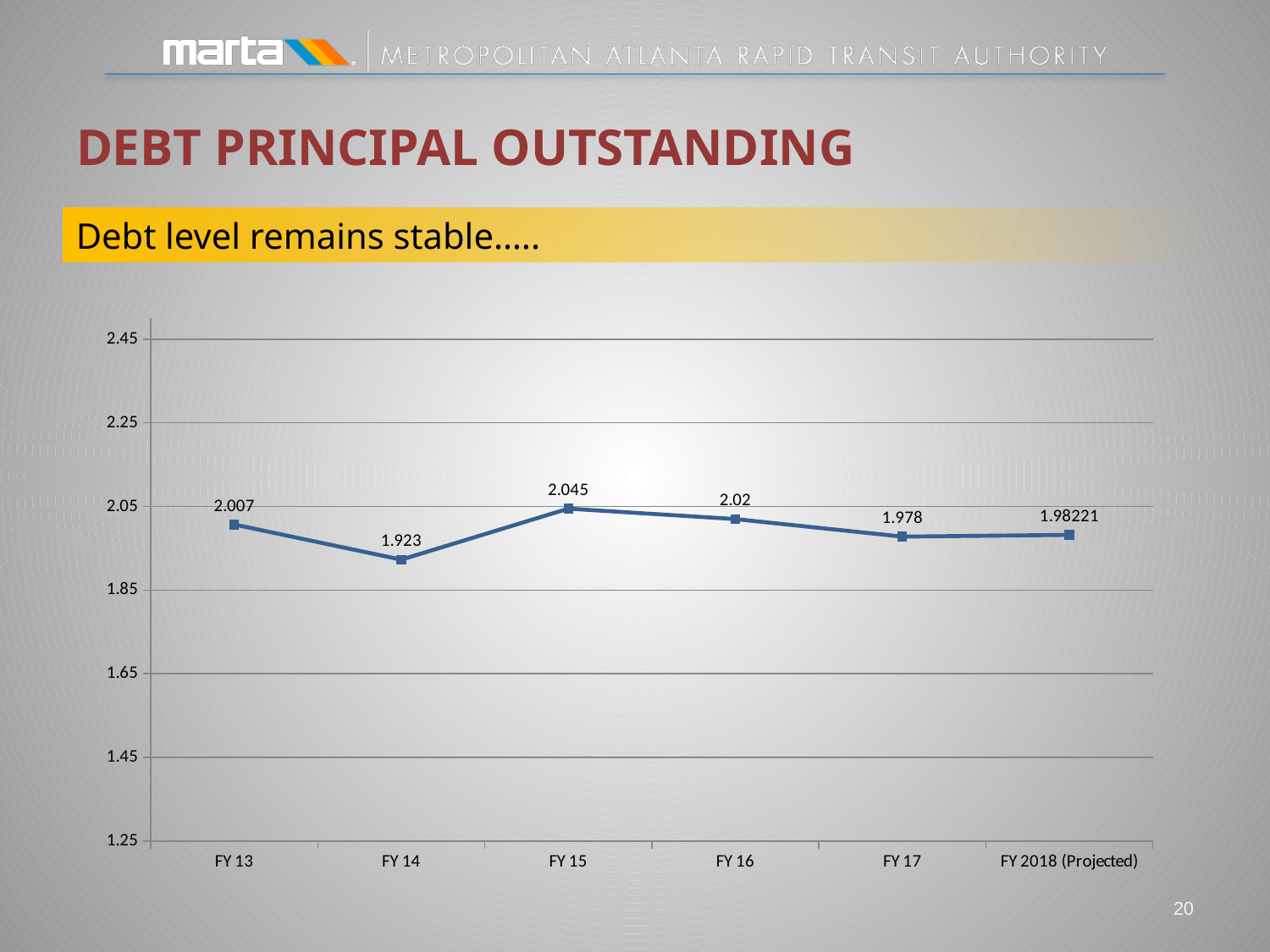
Which fiscal year has the lowest value? FY 14 Does the value rise or fall from FY 13 to FY 14? fall What kind of chart is shown on the slide? line chart What is the title of the slide containing the chart? DEBT PRINCIPAL OUTSTANDING How many fiscal years are plotted on the chart? 6 What is the difference between the values for FY 15 and FY 14? 0.122 Which is larger, the value for FY 16 or the value for FY 17? FY 16 What is the value for FY 14? 1.923 What is the value for FY 13? 2.007 What is the value for FY 2018 (Projected)? 1.98221 Is the value for FY 15 greater or less than 2.25? less Which fiscal year has the highest value? FY 15